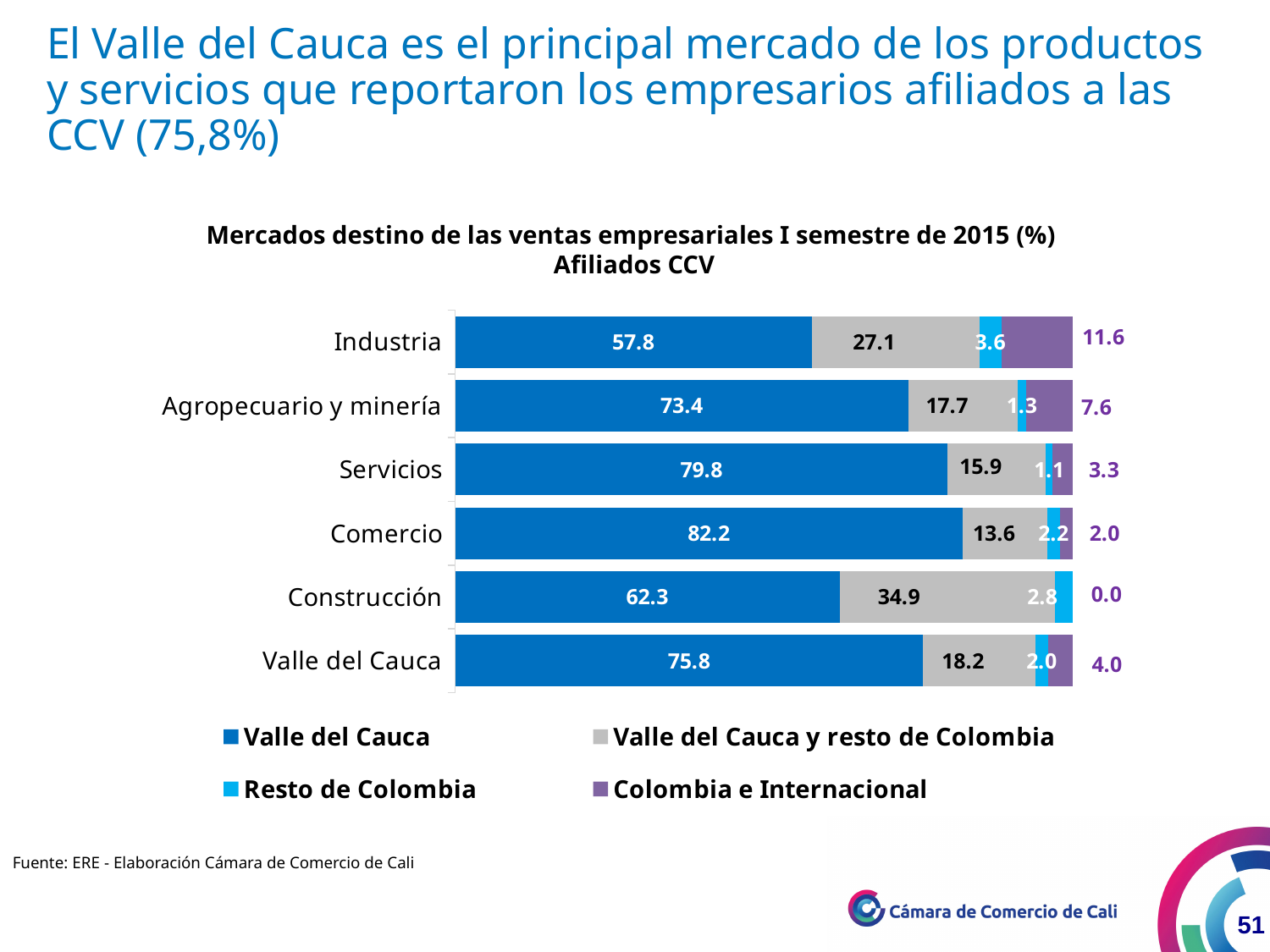
What is the title of the chart? Mercados destino de las ventas empresariales I semestre de 2015 (%) Afiliados CCV What is the difference between the Valle del Cauca values for Servicios and Industria? 22.0 Which is larger, the Valle del Cauca y resto de Colombia value for Industria or for Servicios? Industria What type of chart is shown on the slide? Stacked bar chart What is the Colombia e Internacional value for Industria? 11.6 Which category has the lowest Valle del Cauca value? Industria What is the Valle del Cauca value for Comercio? 82.2 What is the Valle del Cauca y resto de Colombia value for Construcción? 34.9 How many categories are shown on the vertical axis of the chart? 6 What is the Resto de Colombia value for Agropecuario y minería? 1.3 How many series does the legend list? 4 Which category has the highest Valle del Cauca value? Comercio